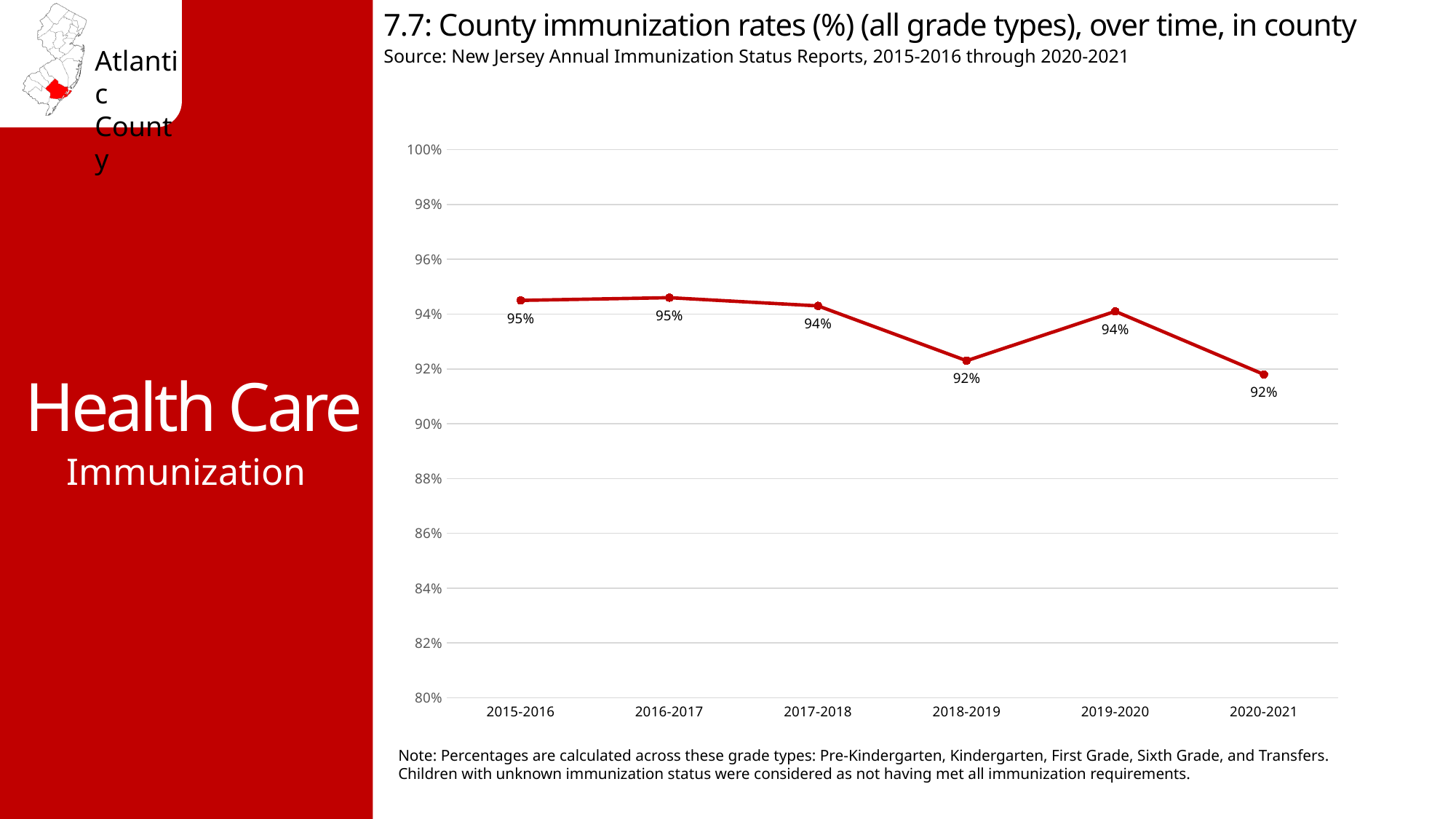
Is the immunization rate for 2020-2021 greater or less than 90%? greater Which school year has the higher immunization rate, 2019-2020 or 2020-2021? 2019-2020 Overall, does the immunization rate rise or fall from 2015-2016 to 2020-2021? fall What is the county immunization rate for 2017-2018? 94% What is the county immunization rate for 2018-2019? 92% How many school years are plotted on the chart? 6 What is the difference between the immunization rate in 2016-2017 and in 2018-2019? 3 percentage points What is the county immunization rate for 2015-2016? 95% Which school year has the higher immunization rate, 2017-2018 or 2018-2019? 2017-2018 What is the county immunization rate for 2020-2021? 92% What kind of chart is shown on the slide? line chart What is the source cited for the chart data? New Jersey Annual Immunization Status Reports, 2015-2016 through 2020-2021